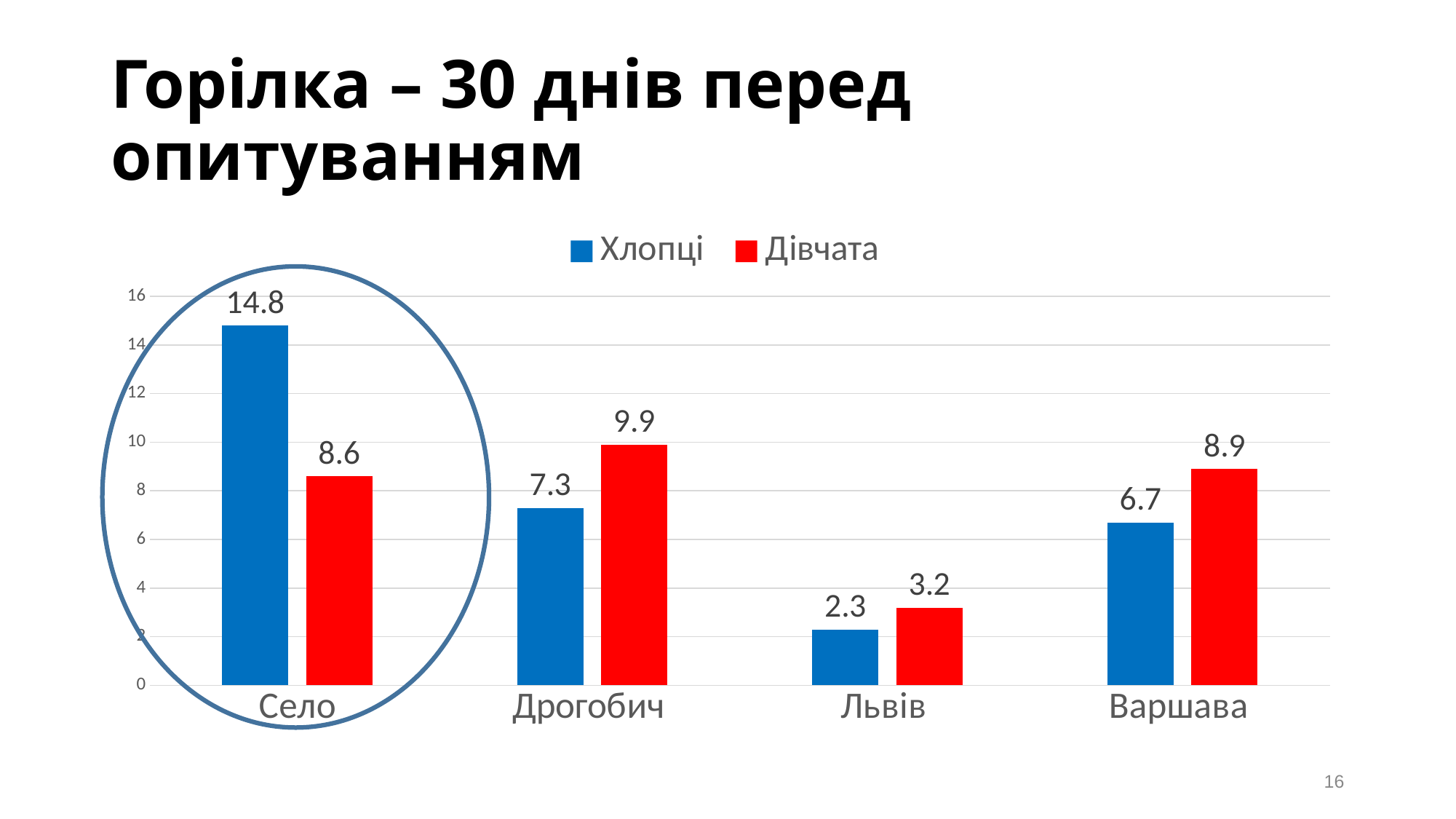
What is the value for Хлопці in Львів? 2.3 What is the value for Дівчата in Варшава? 8.9 How many categories are shown on the x axis? 4 Which category has the highest value for Хлопці? Село How many series does the legend list? 2 What is the value for Хлопці in Село? 14.8 What is the value for Дівчата in Дрогобич? 9.9 What is the difference between Хлопці and Дівчата in Село? 6.2 Which category is circled on the chart? Село What kind of chart is shown on the slide? Bar chart Which category has the lowest value for Дівчата? Львів Which is larger in Варшава, Хлопці or Дівчата? Дівчата